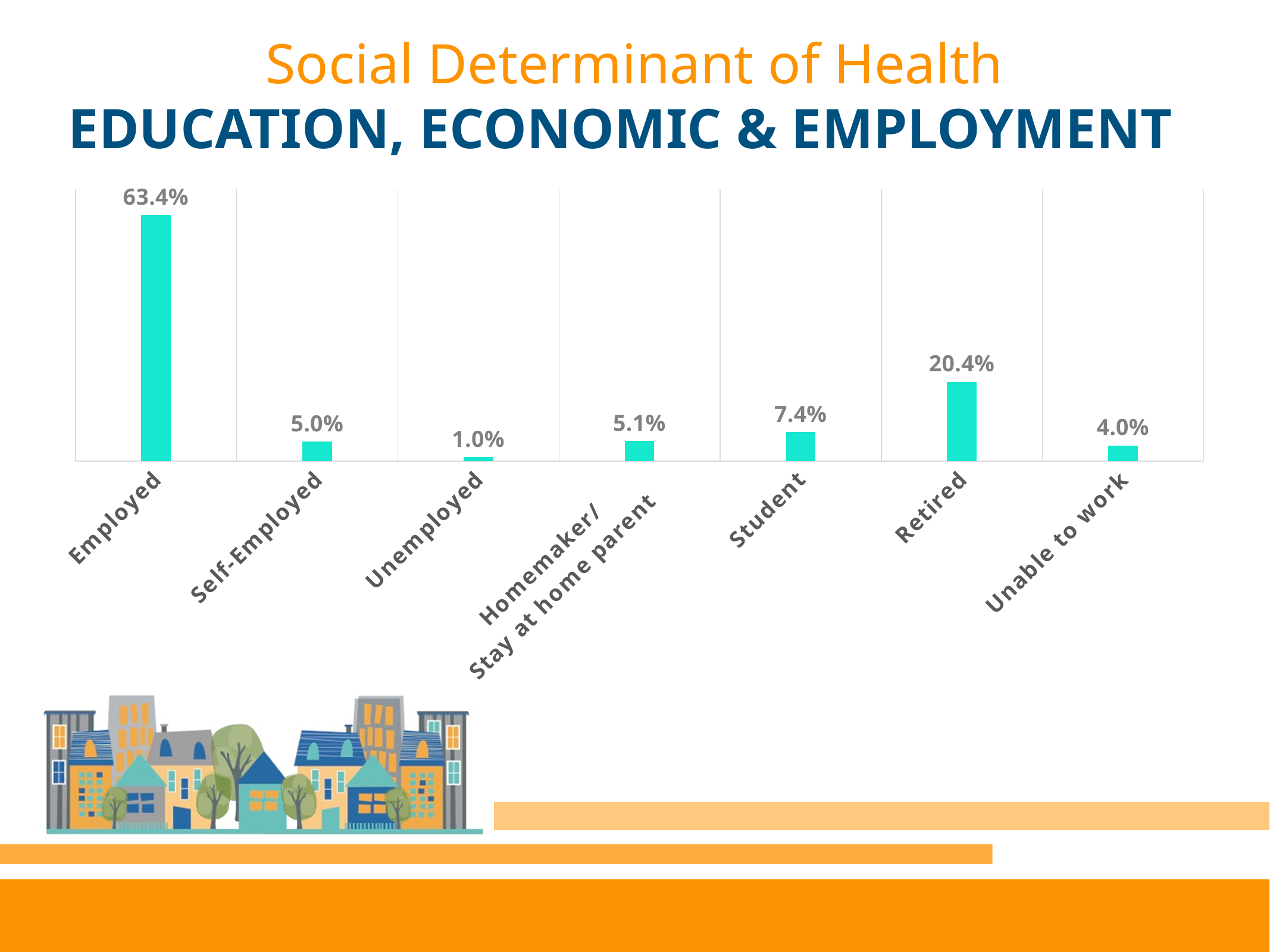
Which category has the highest value? Employed What colour are the bars in the chart? Teal What is the value for Unable to work? 4.0% What is the value for Homemaker/Stay at home parent? 5.1% Which is larger, the value for Student or the value for Unable to work? Student Which category has the lowest value? Unemployed What is the value for Retired? 20.4% What is the difference between the values for Employed and Retired? 43.0% How many categories are shown in the chart? 7 What is the difference between the values for Student and Self-Employed? 2.4% What is the value for Employed? 63.4% What kind of chart is shown on the slide? Bar chart